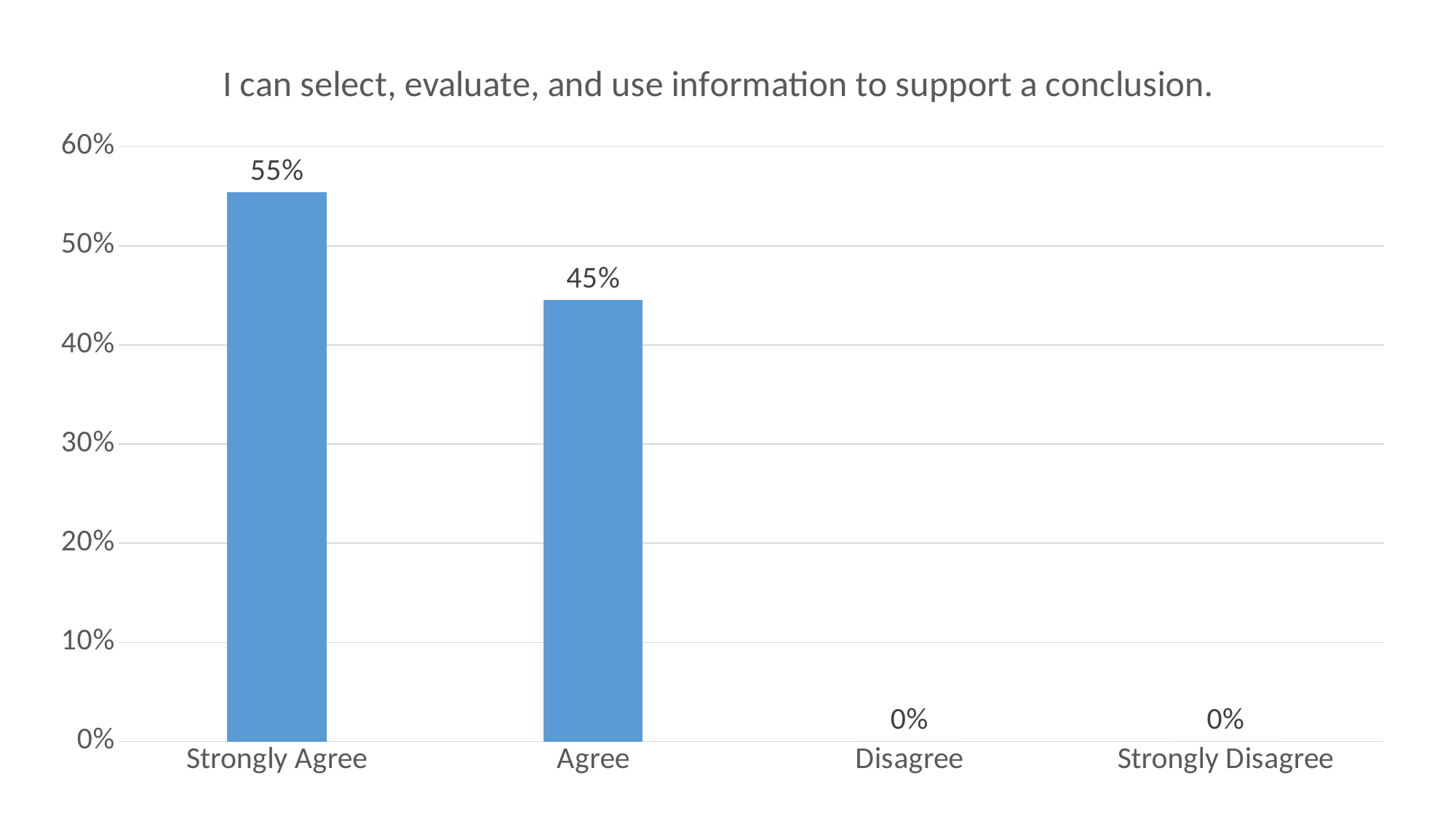
What is the value for Disagree? 0% Which is larger, the value for Strongly Agree or the value for Agree? Strongly Agree What is the value for Strongly Disagree? 0% What kind of chart is shown on the slide? bar chart Do the values rise or fall from left to right along the x axis? fall How many categories are shown on the x axis? 4 What is the title of the chart? I can select, evaluate, and use information to support a conclusion. What is the difference between the values for Strongly Agree and Agree? 10% What is the value for Agree? 45% Is the value for Agree greater or less than 50%? less What is the value for Strongly Agree? 55% Which category has the highest value? Strongly Agree